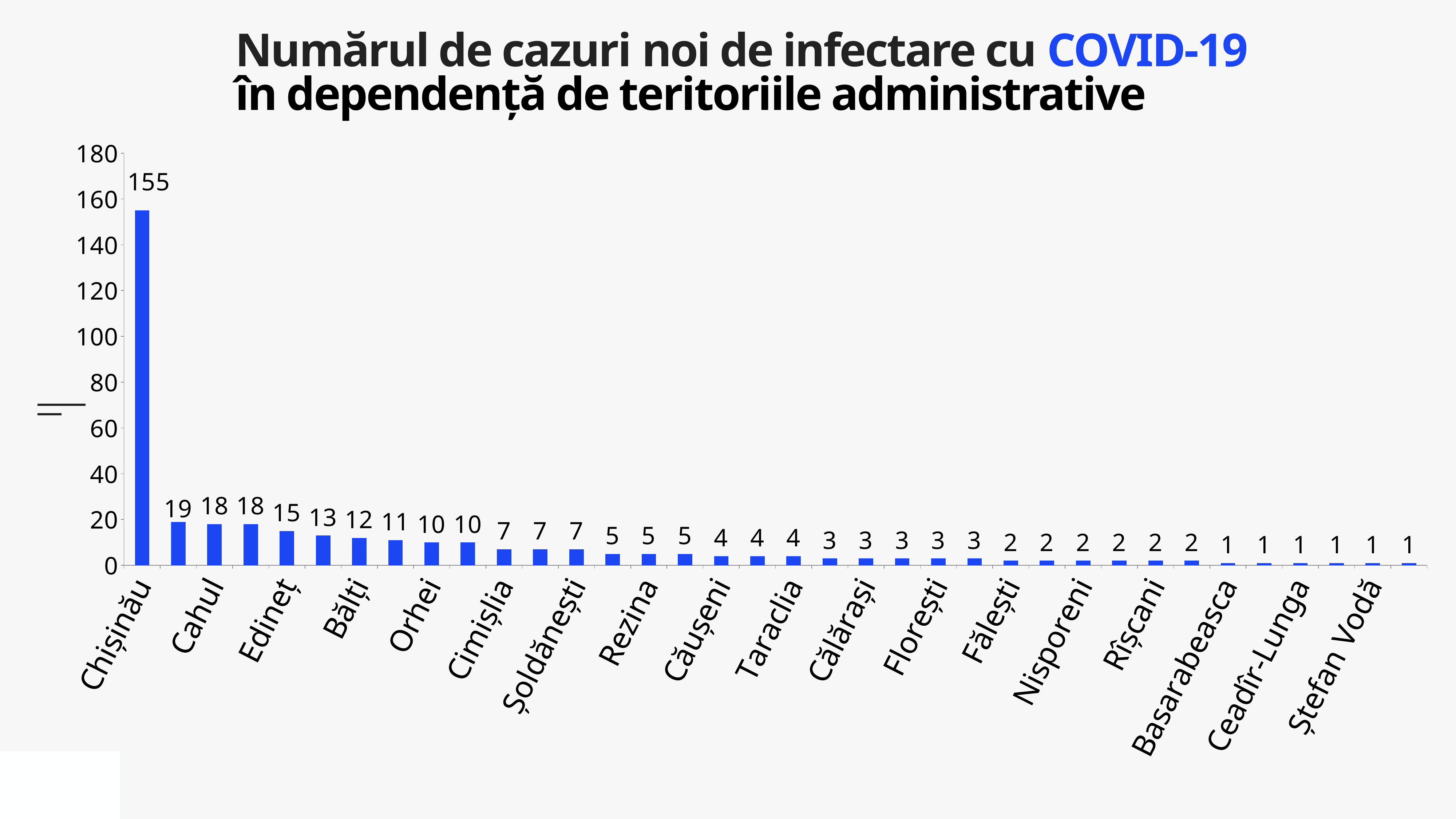
Is the value for Chișinău greater or less than 140? greater What is the highest tick value shown on the vertical axis? 180 What is the difference between the highest value (155) and the lowest value (1)? 154 How many bars are plotted in the chart? 36 Do the values rise or fall from left to right along the x axis? fall What is the highest value shown in the chart? 155 What type of chart is shown on the slide? bar chart Which category has the highest value? Chișinău What is the lowest value shown in the chart? 1 Is the value for Ștefan Vodă greater or less than 20? less Which is larger, the value for Chișinău or the value for Cahul? Chișinău What is the value for Chișinău? 155